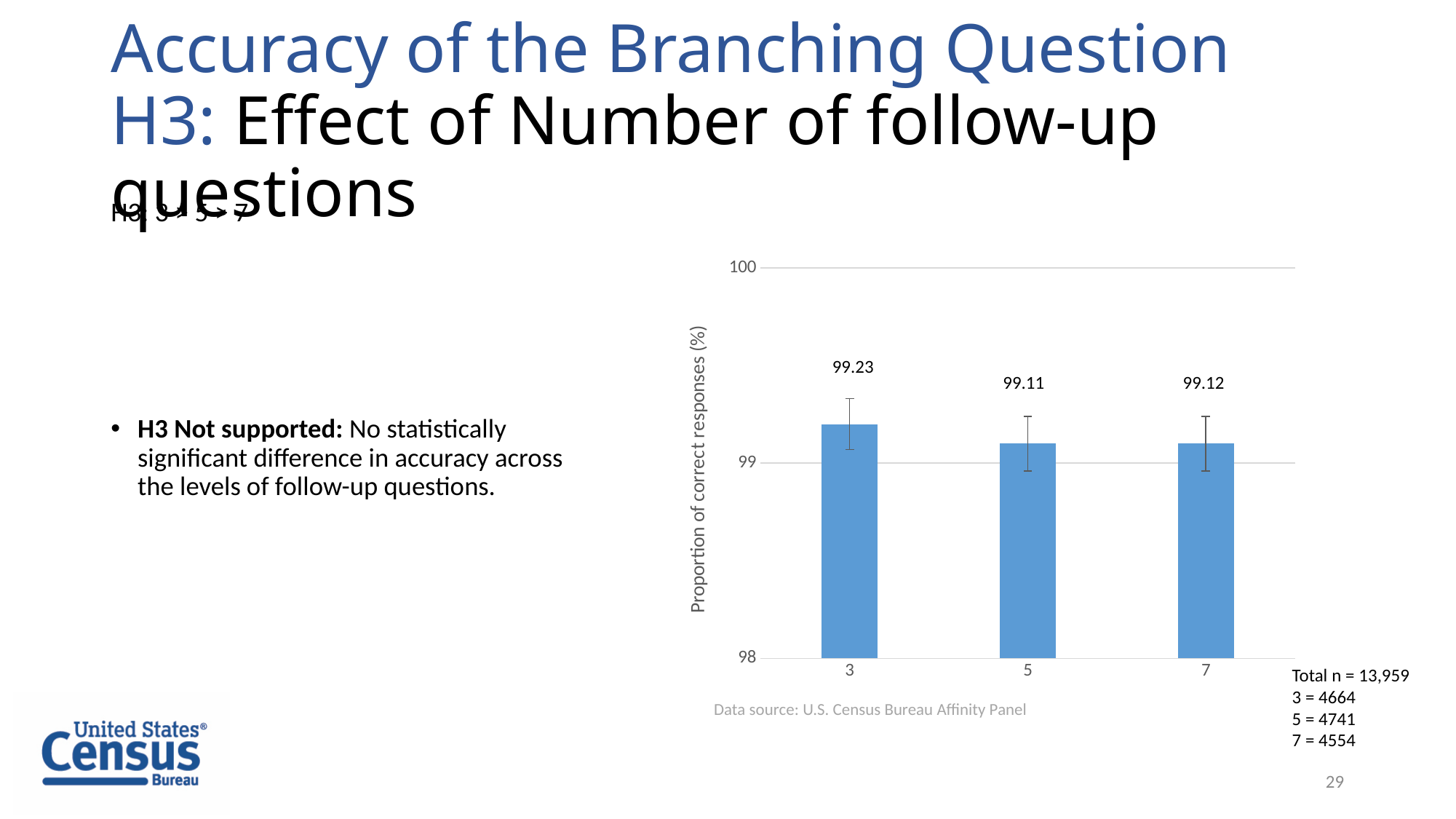
Which has a larger proportion of correct responses, 3 or 5 follow-up questions? 3 Is the value for 3 follow-up questions greater or less than 100? less Is the value for 5 follow-up questions greater or less than 99? greater What is the difference between the proportion of correct responses for 3 and for 5 follow-up questions? 0.12 What is the proportion of correct responses for 5 follow-up questions? 99.11 How many categories are shown on the x axis of the chart? 3 What kind of chart is shown on the slide? Bar chart Which number of follow-up questions has the highest proportion of correct responses? 3 What is the difference between the proportion of correct responses for 3 and for 7 follow-up questions? 0.11 What is the label of the y axis of the chart? Proportion of correct responses (%) What is the proportion of correct responses for 3 follow-up questions? 99.23 What is the proportion of correct responses for 7 follow-up questions? 99.12